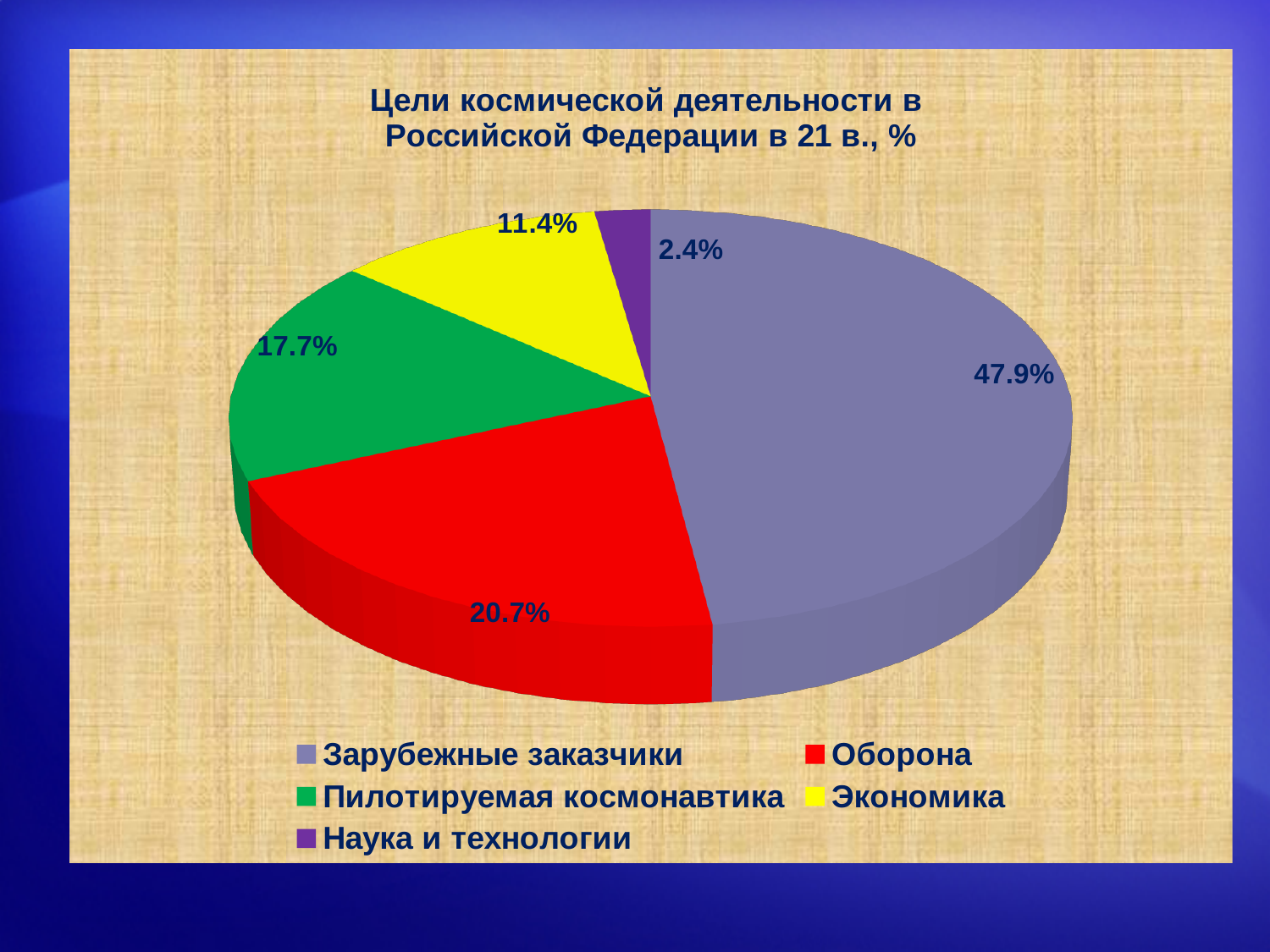
What is the value for Наука и технологии? 2.4% What is the value for Экономика? 11.4% Which category has the smallest slice? Наука и технологии What is the value for Пилотируемая космонавтика? 17.7% What kind of chart is shown on the slide? Pie chart Which category has the largest slice? Зарубежные заказчики What colour is the slice for Оборона? Red How many categories does the pie chart show? 5 What share of the pie does Зарубежные заказчики have? 47.9% What is the difference between Оборона and Пилотируемая космонавтика? 3.0% Which is larger, Экономика or Пилотируемая космонавтика? Пилотируемая космонавтика What is the value for Оборона? 20.7%